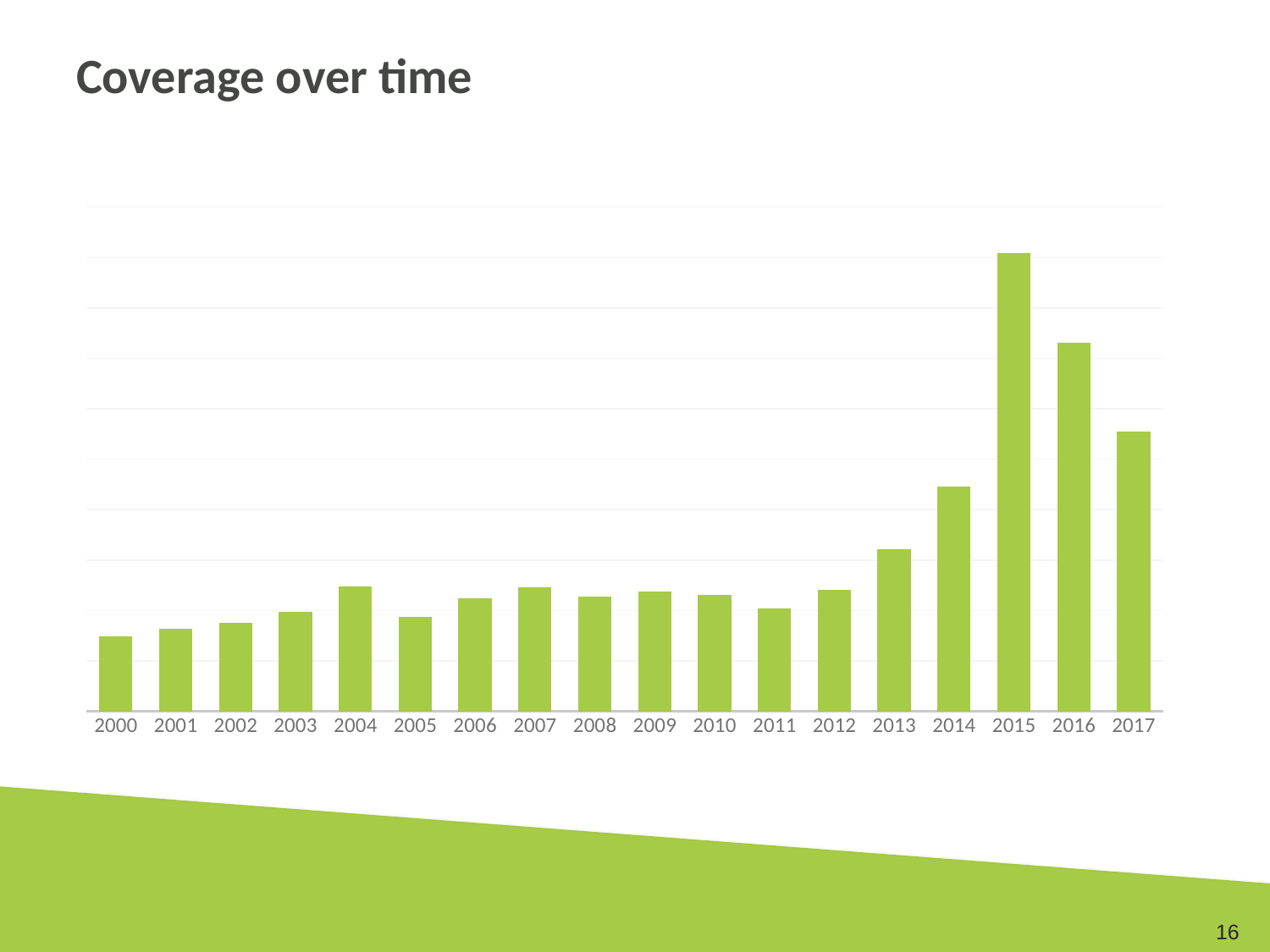
Do the values rise or fall from 2011 to 2015? Rise What colour are the bars in the chart? Green Which year has a higher value, 2004 or 2005? 2004 What is the title of the chart? Coverage over time Do the values rise or fall from 2015 to 2017? Fall Which year has the highest bar in the chart? 2015 Which year has a higher value, 2015 or 2016? 2015 Which year has a higher value, 2013 or 2014? 2014 Which year has the second highest bar in the chart? 2016 What kind of chart is shown on the slide? Bar chart Which year has the lowest bar in the chart? 2000 How many years are shown on the x axis of the chart? 18